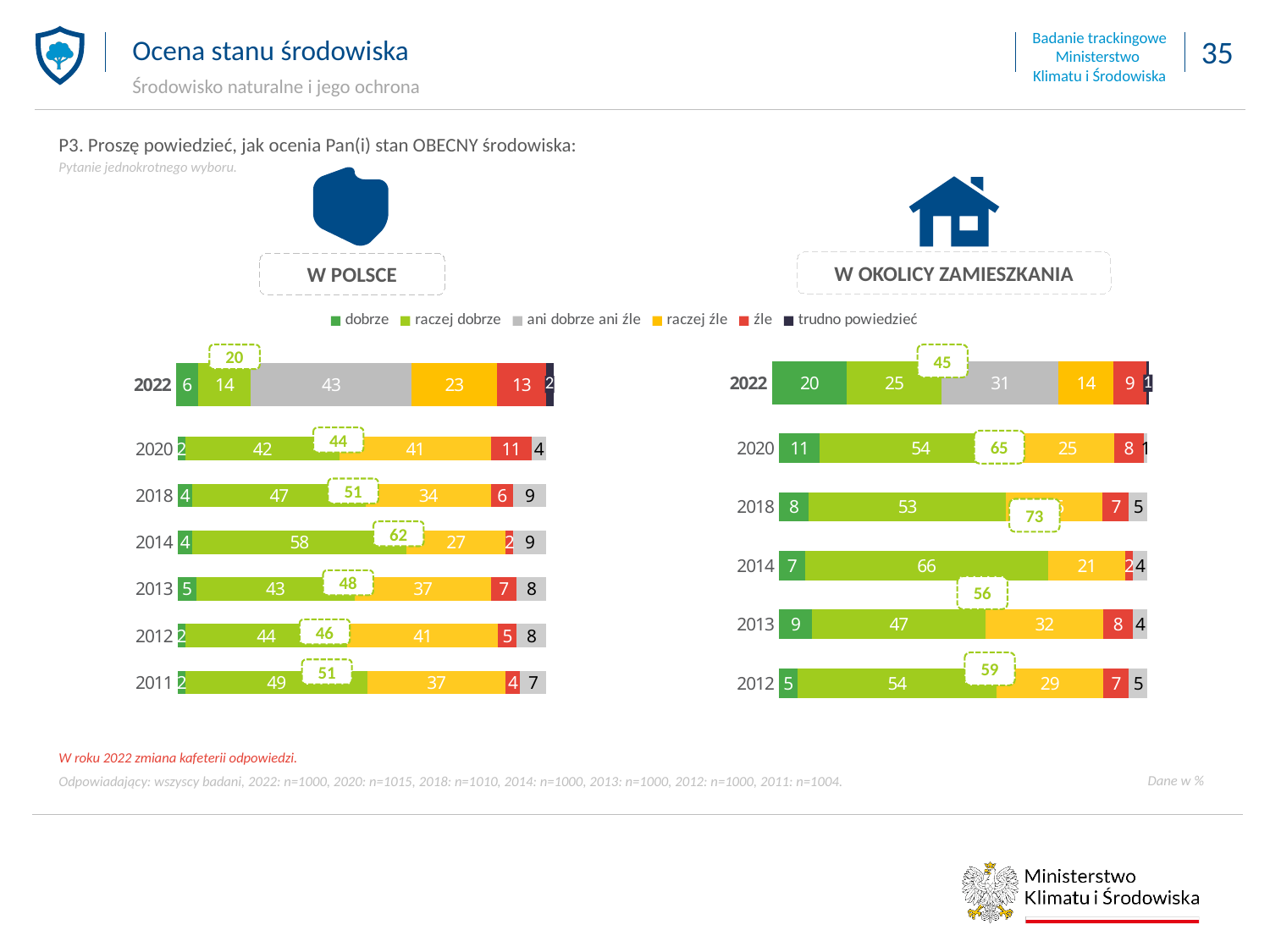
On the 'W POLSCE' chart, which is larger: the 'źle' value in 2022 or in 2020? 2022 On the 'W POLSCE' chart, what is the value for 'ani dobrze ani źle' in 2022? 43 On the 'W OKOLICY ZAMIESZKANIA' chart, what is the difference between the 'raczej dobrze' values for 2014 and 2022? 41 What kind of chart is the 'W POLSCE' chart? Stacked bar chart On the 'W OKOLICY ZAMIESZKANIA' chart, what is the value for 'dobrze' in 2022? 20 How many years are shown on the 'W POLSCE' chart? 7 On the 'W OKOLICY ZAMIESZKANIA' chart, what is the value for 'raczej źle' in 2013? 32 How many series does the legend list? 6 How many years are shown on the 'W OKOLICY ZAMIESZKANIA' chart? 6 On the 'W POLSCE' chart, in which year is the 'raczej dobrze' value highest? 2014 On the 'W POLSCE' chart, what is the value for 'raczej dobrze' in 2014? 58 On the 'W OKOLICY ZAMIESZKANIA' chart, what is the combined 'dobrze' and 'raczej dobrze' value shown in the callout for 2020? 65